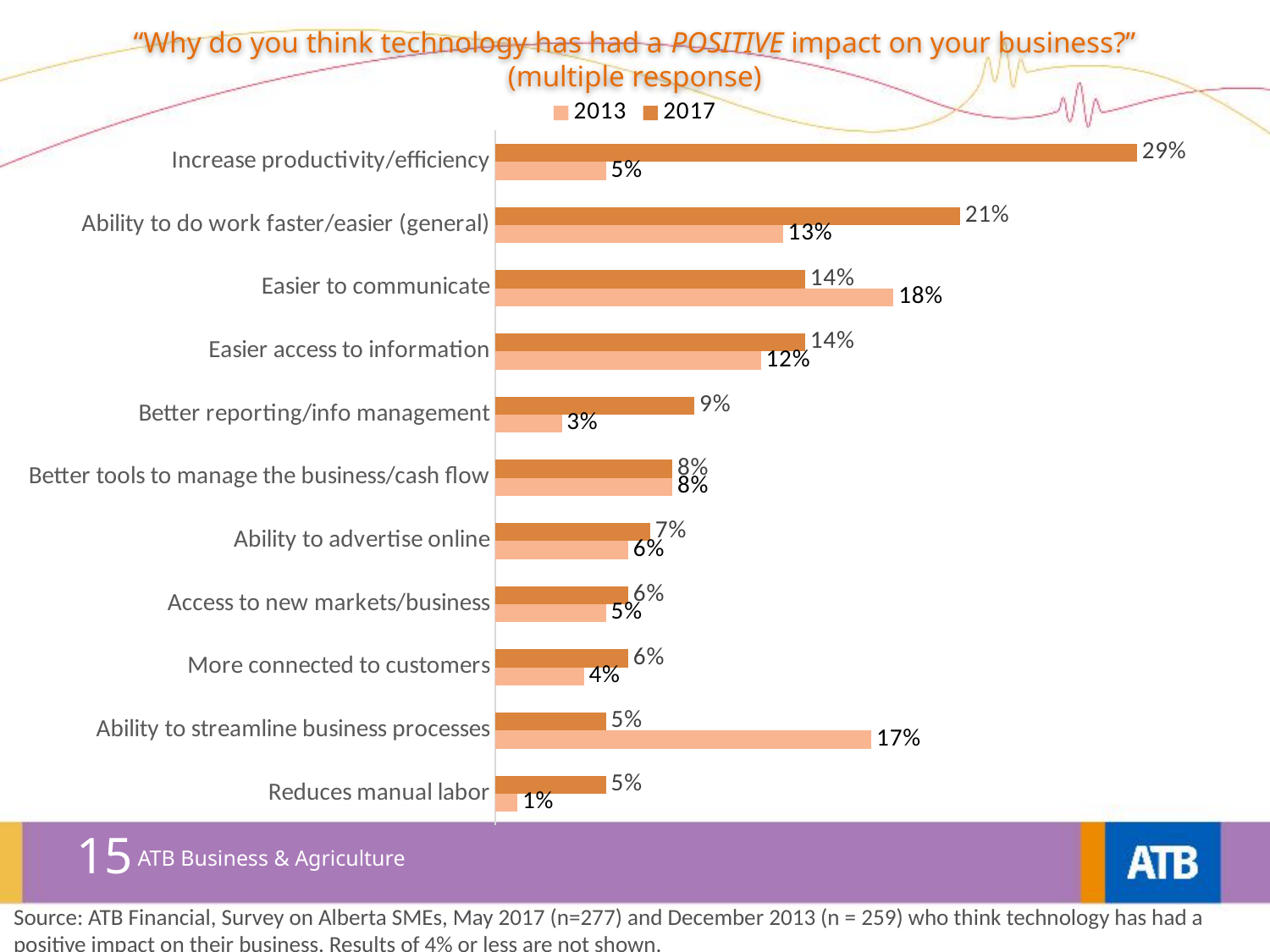
What is the 2013 value for Ability to streamline business processes? 17% Which category has the lowest 2013 value? Reduces manual labor What is the 2013 value for Easier to communicate? 18% How many series does the legend list? 2 Which is larger for Easier to communicate, the 2013 value or the 2017 value? 2013 What is the 2017 value for Increase productivity/efficiency? 29% What is the difference between the 2017 and 2013 values for Increase productivity/efficiency? 24% Which is larger for Ability to do work faster/easier (general), the 2013 value or the 2017 value? 2017 How many categories are shown in the chart? 11 Which series is shown in the darker orange colour? 2017 What kind of chart is shown on the slide? Bar chart Which category has the highest 2017 value? Increase productivity/efficiency